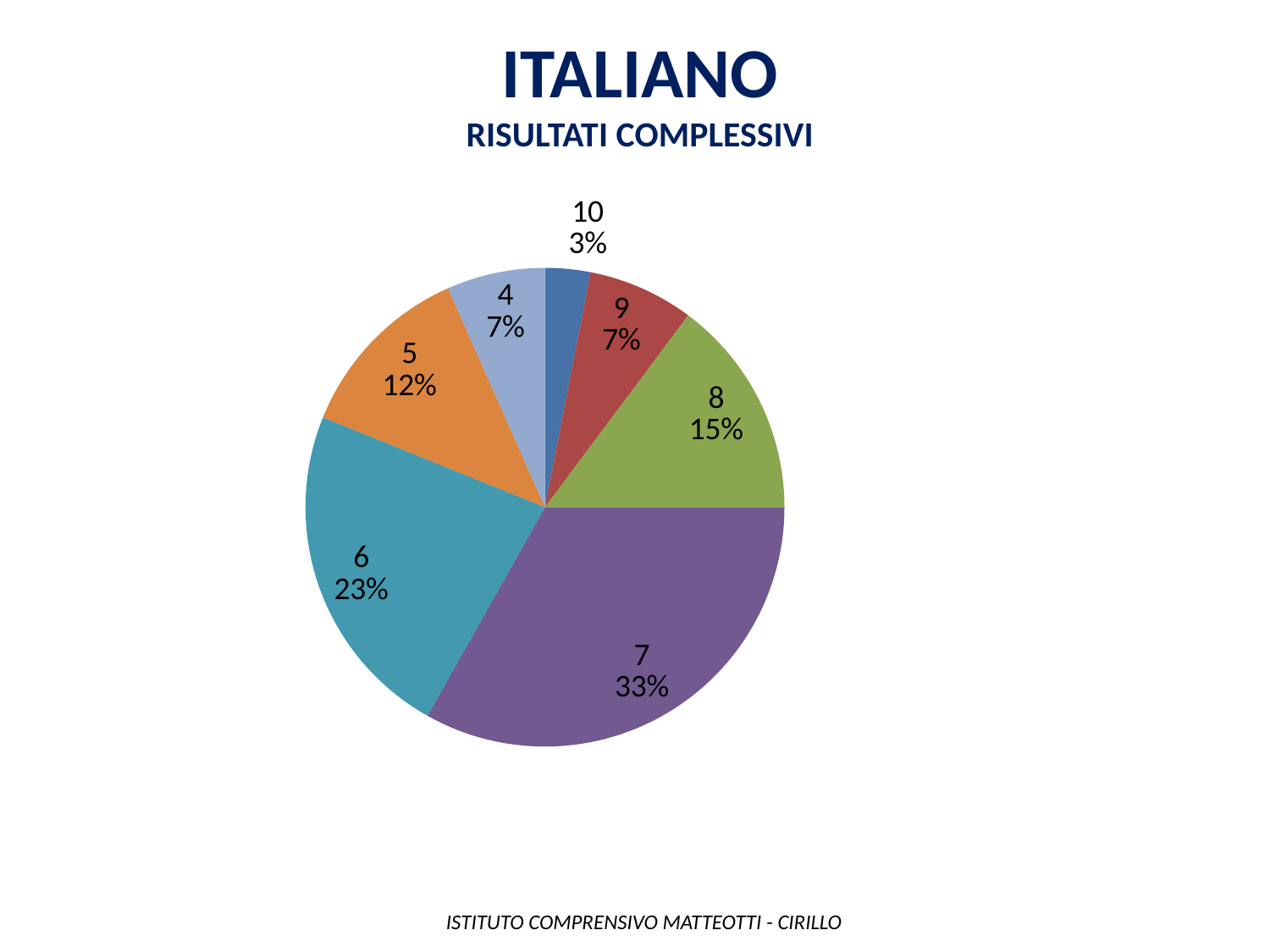
What share of the pie does the slice for grade 8 represent? 15% What share of the pie does the slice for grade 6 represent? 23% What share of the pie does the slice for grade 5 represent? 12% Which grade has the smallest slice of the pie? 10 What is the difference in percentage points between the slices for grade 7 and grade 6? 10% Which slice is larger, grade 8 or grade 5? 8 Which grade has the largest slice of the pie? 7 What is the title shown above the chart? ITALIANO RISULTATI COMPLESSIVI What kind of chart is shown on the slide? pie chart How many slices does the pie chart have? 7